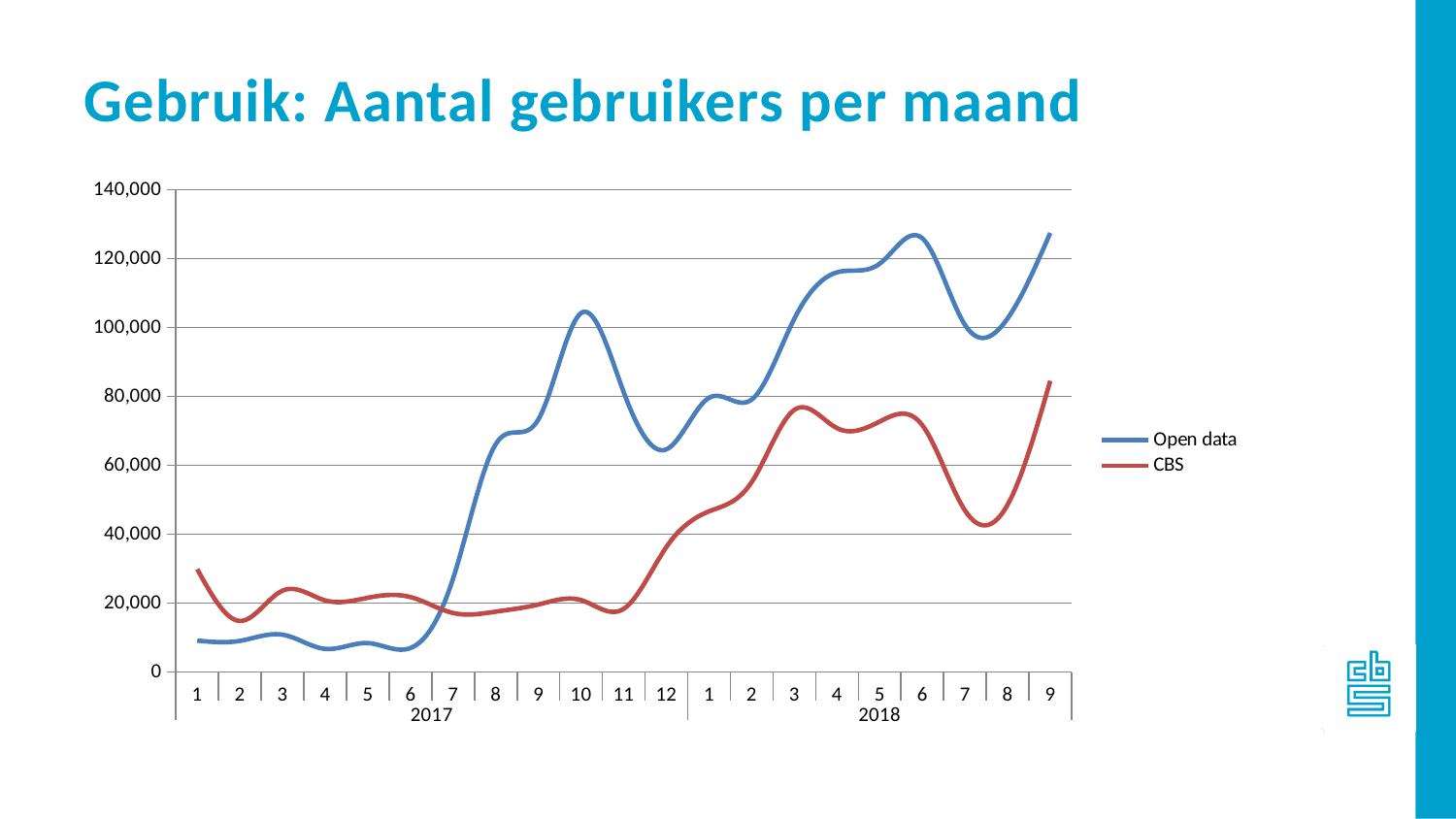
Is the value for Open data in month 6 of 2018 greater or less than 120,000? greater Does the Open data series generally rise or fall from the start of 2017 to the end of the plotted period in 2018? rise In month 9 of 2018, which series has the higher value, Open data or CBS? Open data In month 1 of 2017, which series has the higher value, Open data or CBS? CBS Is the value for Open data in month 1 of 2017 greater or less than 20,000? less Which two series are listed in the legend? Open data and CBS How many series does the legend list? 2 What is the title of the slide? Gebruik: Aantal gebruikers per maand What kind of chart is shown on the slide? Line chart How many monthly data points are plotted along the x axis? 21 Is the value for CBS in month 7 of 2018 greater or less than 60,000? less